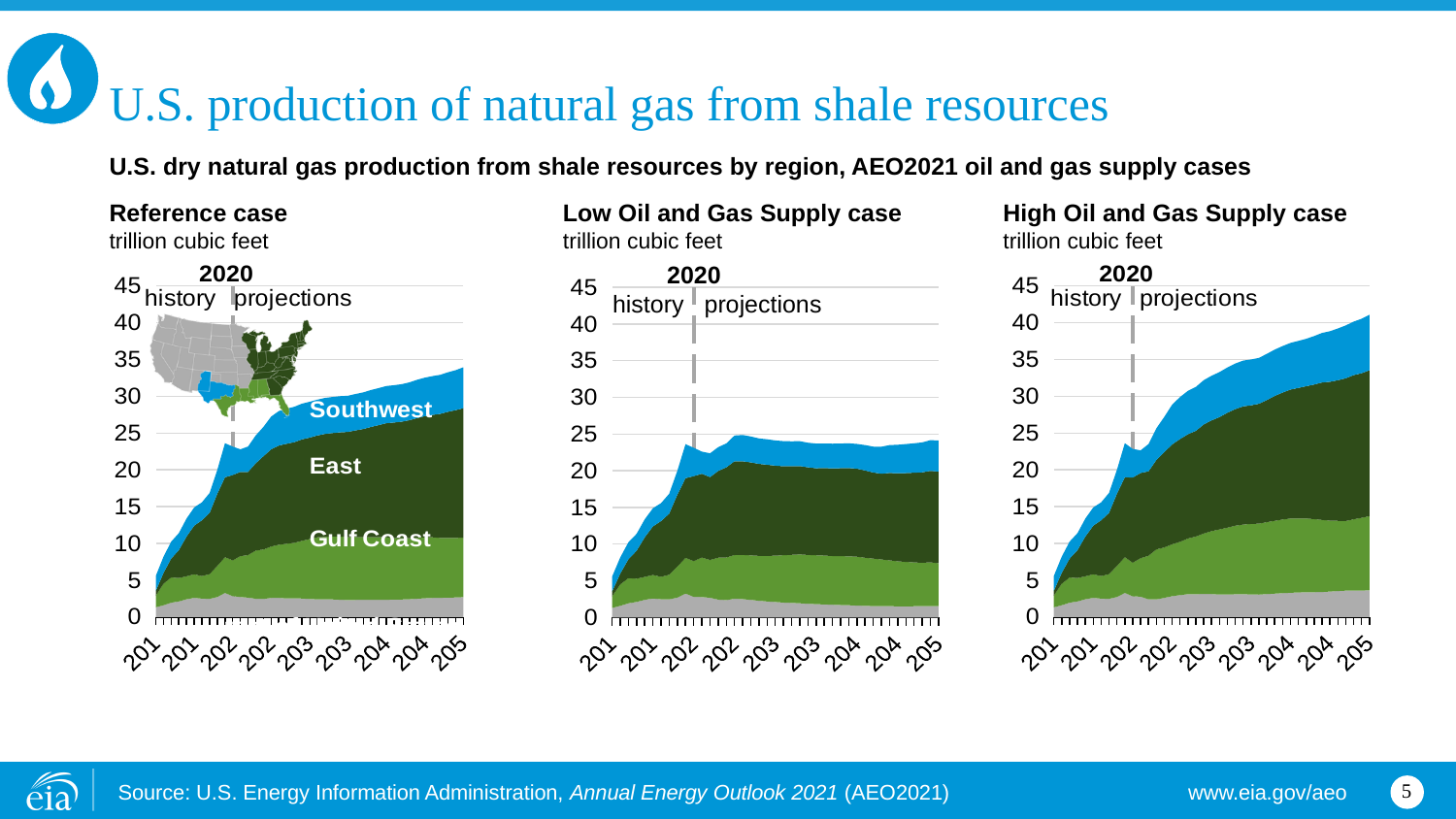
Which chart shows the higher total shale gas production in 2050, the Low Oil and Gas Supply case or the High Oil and Gas Supply case? High Oil and Gas Supply case In the High Oil and Gas Supply case chart, does total production rise or fall over the projection period after 2020? rise What type of chart is the Reference case chart? stacked area chart In the Reference case chart, which region is the largest contributor to shale gas production in the projection period? East What unit is used on the y-axis of the three charts? trillion cubic feet What year does the dashed vertical line separating history from projections mark? 2020 In the Low Oil and Gas Supply case chart, is the total shale gas production in 2050 greater or less than 30 trillion cubic feet? less In the Reference case chart, is the total shale gas production at the end of the projection period (2050) greater or less than 30 trillion cubic feet? greater How many charts are shown on the slide? 3 In the High Oil and Gas Supply case chart, is the total shale gas production in 2050 greater or less than 35 trillion cubic feet? greater